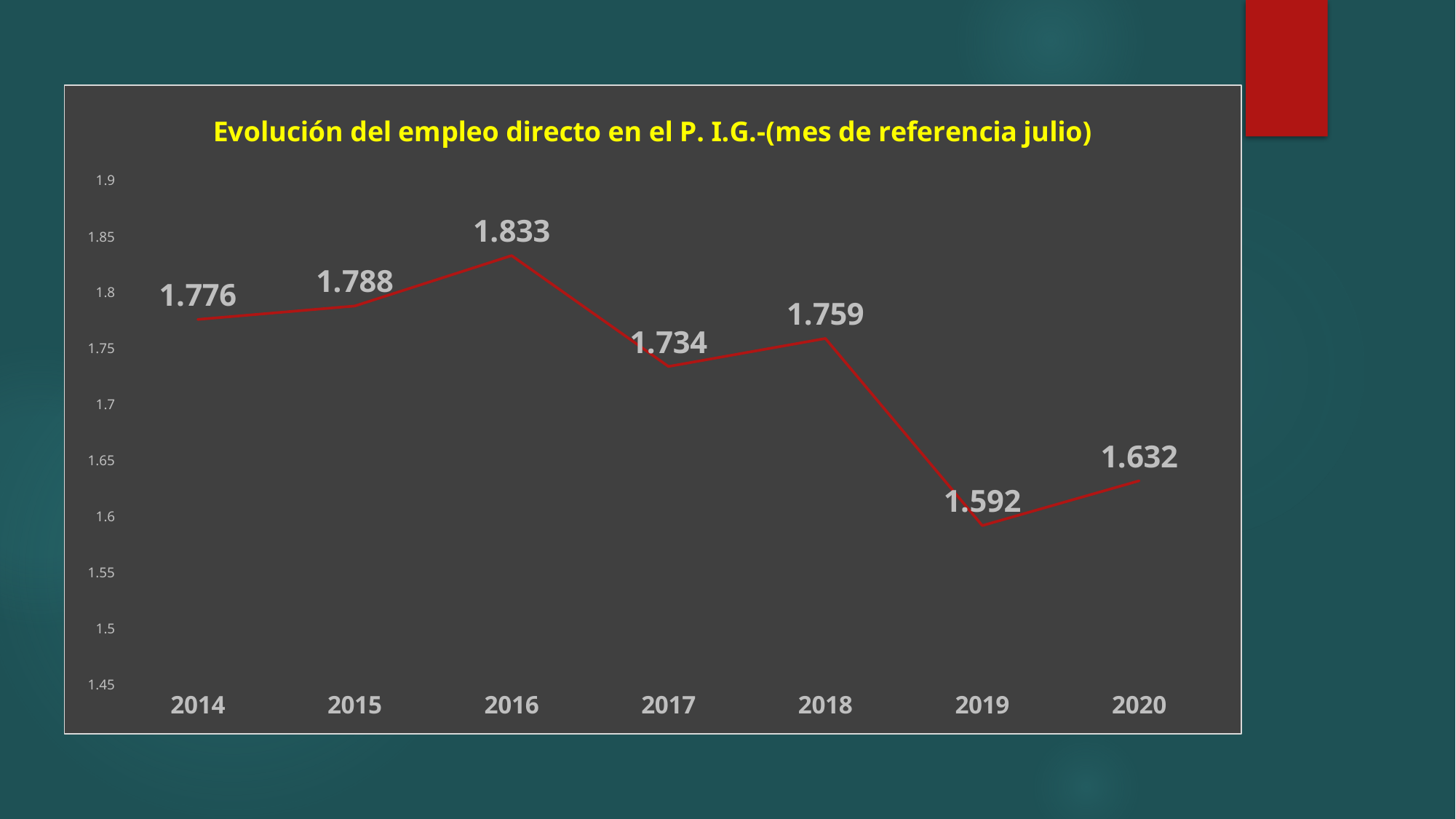
Which year has the lowest value? 2019 What is the title of the chart? Evolución del empleo directo en el P. I.G.-(mes de referencia julio) What is the value for 2020? 1.632 Does the value rise or fall from 2018 to 2019? fall What is the value for 2017? 1.734 Is the value for 2019 greater or less than 1.6? less Is the value for 2016 greater or less than 1.8? greater What type of chart is shown on the slide? line chart Which is larger, the value for 2015 or the value for 2018? 2015 How many years are plotted on the x axis? 7 Which year has the highest value? 2016 What is the value for 2014? 1.776